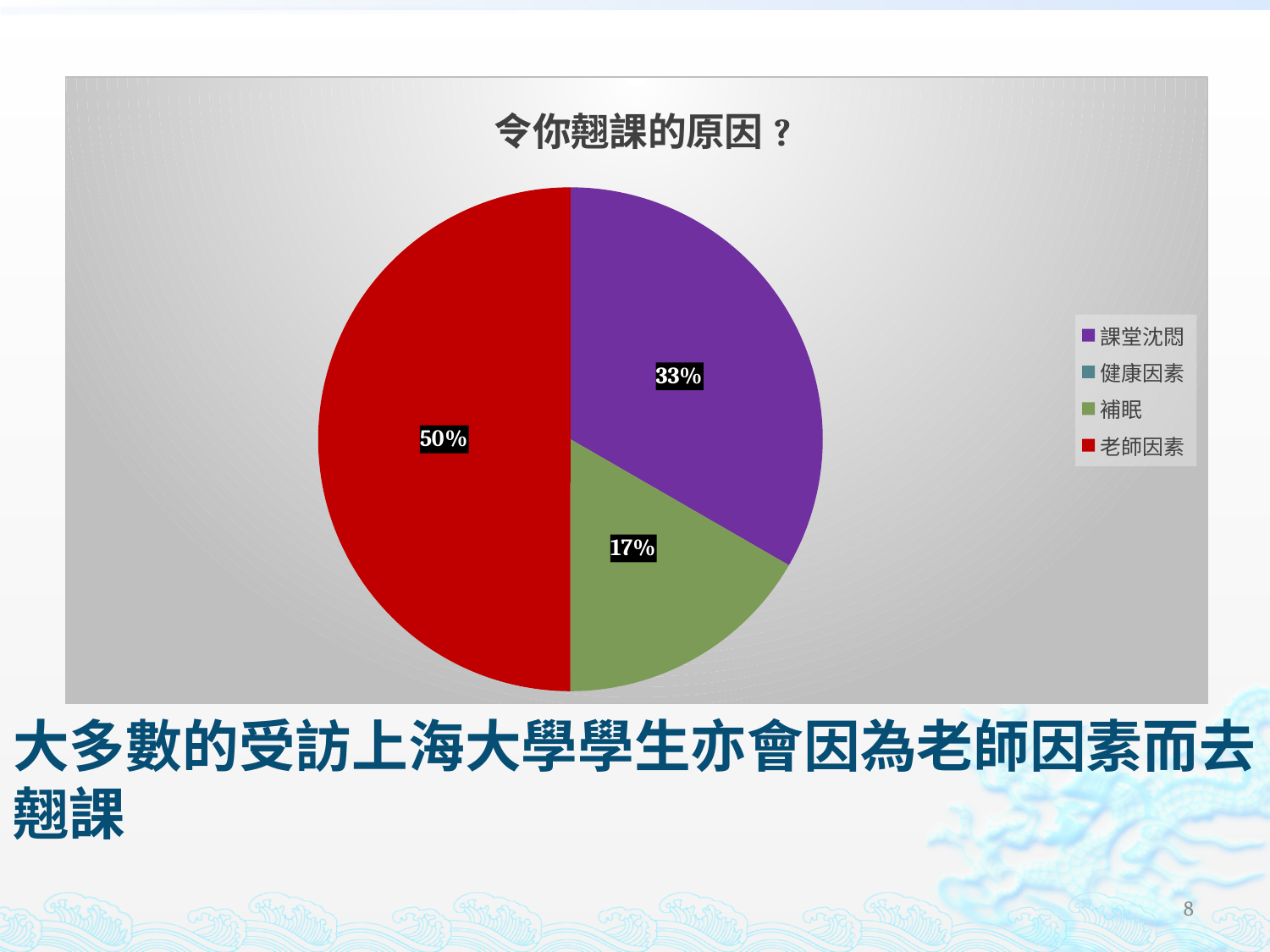
What is the difference in percentage points between 老師因素 and 課堂沈悶? 17 Which is larger, the slice for 課堂沈悶 or the slice for 補眠? 課堂沈悶 Which of the visibly plotted slices is the smallest? 補眠 What percentage of the pie is 老師因素? 50% What type of chart is shown on the slide? pie chart What percentage of the pie is 補眠? 17% How many categories does the legend list? 4 Which category has the largest slice of the pie? 老師因素 What colour is the slice for 老師因素? red What is the title of the chart? 令你翹課的原因？ What is the difference in percentage points between 課堂沈悶 and 補眠? 16 What percentage of the pie is 課堂沈悶? 33%